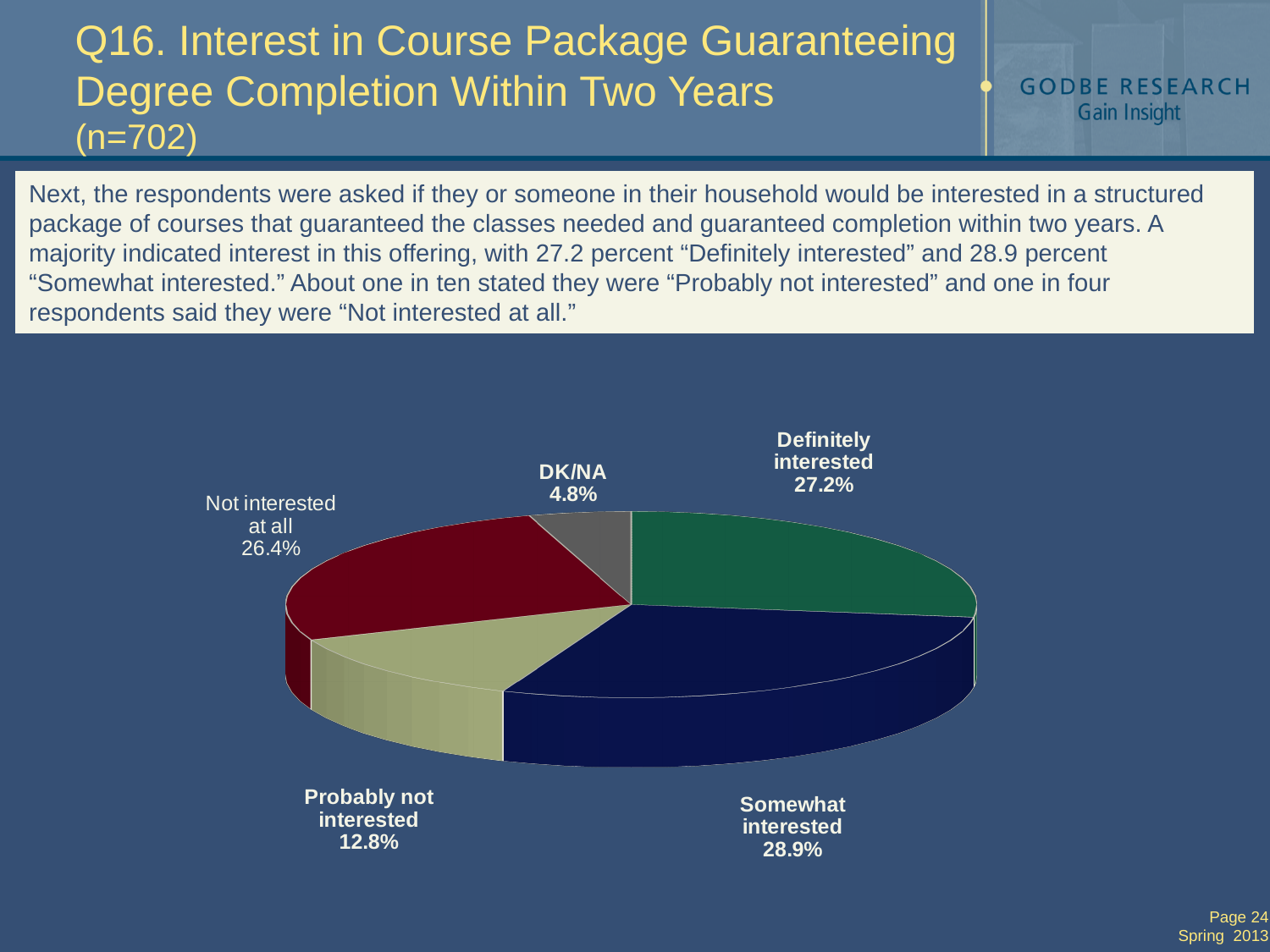
Which response category has the smallest share of the pie? DK/NA What percentage of respondents answered DK/NA? 4.8% Which is larger: the share for "Not interested at all" or the share for "Probably not interested"? Not interested at all What type of chart is shown on the slide? Pie chart How many categories are shown in the pie chart? 5 What percentage of respondents were "Probably not interested"? 12.8% What percentage of respondents were "Somewhat interested"? 28.9% What is the combined percentage of "Definitely interested" and "Somewhat interested" respondents? 56.1% What percentage of respondents were "Not interested at all"? 26.4% What percentage of respondents were "Definitely interested"? 27.2% Which response category has the largest share of the pie? Somewhat interested What is the difference in percentage points between "Somewhat interested" and "Definitely interested"? 1.7